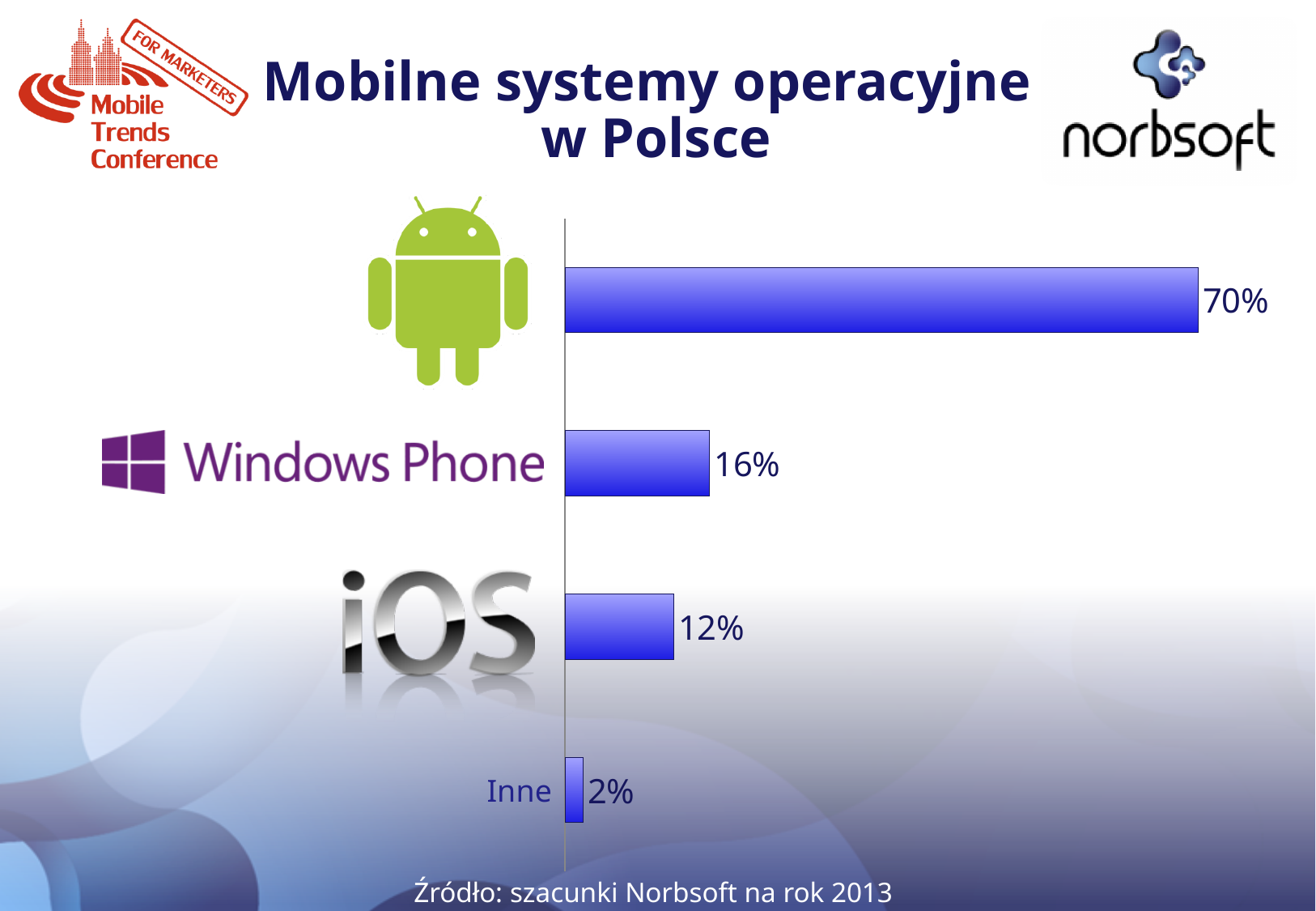
What is the title of the slide containing the chart? Mobilne systemy operacyjne w Polsce Which is larger, the value for Windows Phone or the value for iOS? Windows Phone What is the difference between the values for Windows Phone and iOS? 4% What is the difference between the values for Android and Windows Phone? 54% How many categories are shown in the chart? 4 What is the value for Windows Phone? 16% What is the value for Inne? 2% Which category has the lowest value? Inne Which category has the highest value? Android What is the value for Android (the top bar with the Android logo)? 70% What kind of chart is shown on the slide? Bar chart What is the value for iOS? 12%